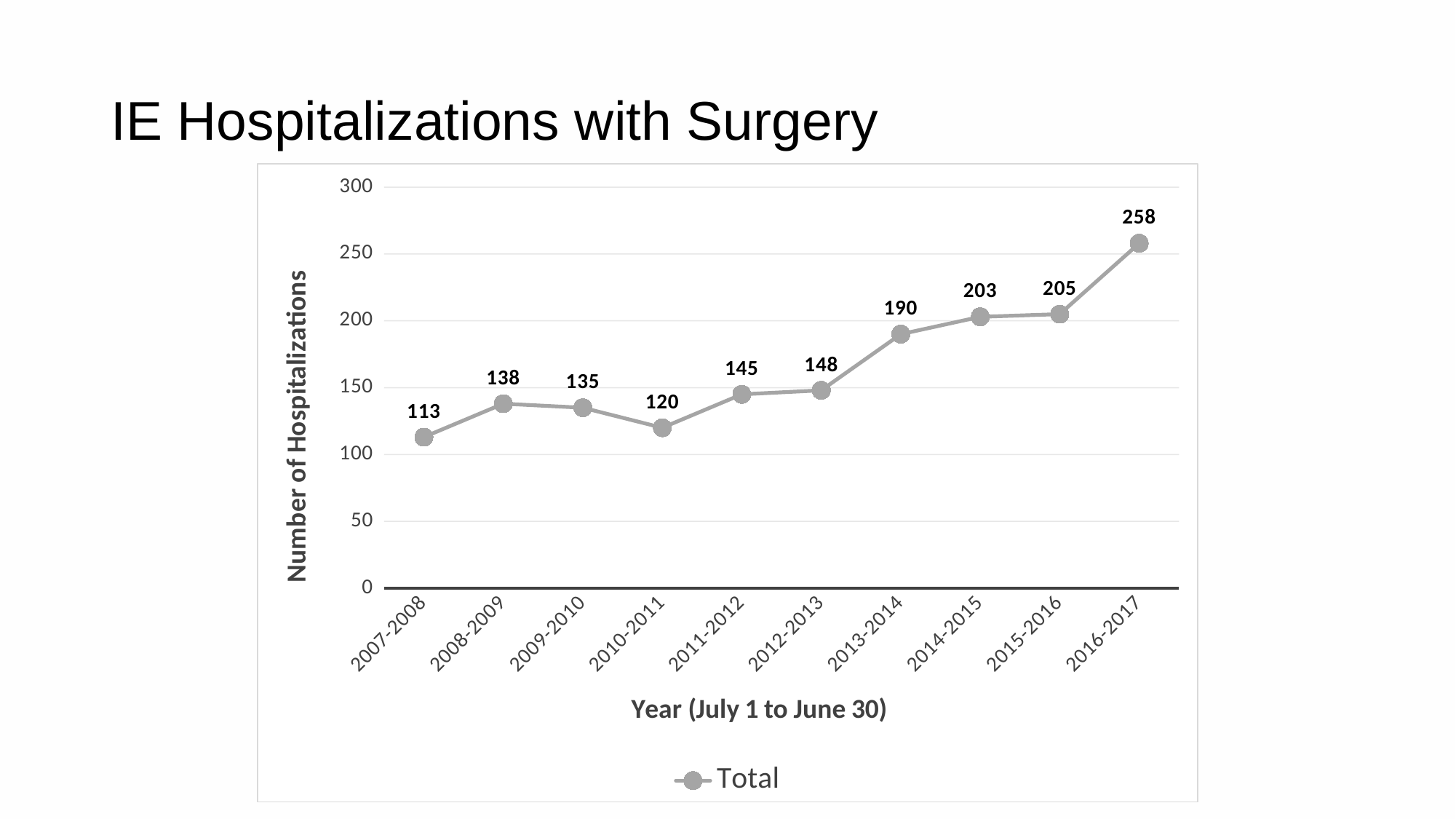
What is the number of hospitalizations for 2013-2014? 190 What is the label of the y axis? Number of Hospitalizations How many years are plotted on the chart? 10 What kind of chart is shown on the slide? line chart Which year has more hospitalizations, 2009-2010 or 2011-2012? 2011-2012 What is the number of hospitalizations for 2016-2017? 258 What is the difference in hospitalizations between 2016-2017 and 2015-2016? 53 Which year has the lowest number of hospitalizations? 2007-2008 What is the difference in hospitalizations between 2008-2009 and 2010-2011? 18 What is the number of hospitalizations for 2007-2008? 113 Which year has the highest number of hospitalizations? 2016-2017 Is the value for 2012-2013 greater or less than 150? less